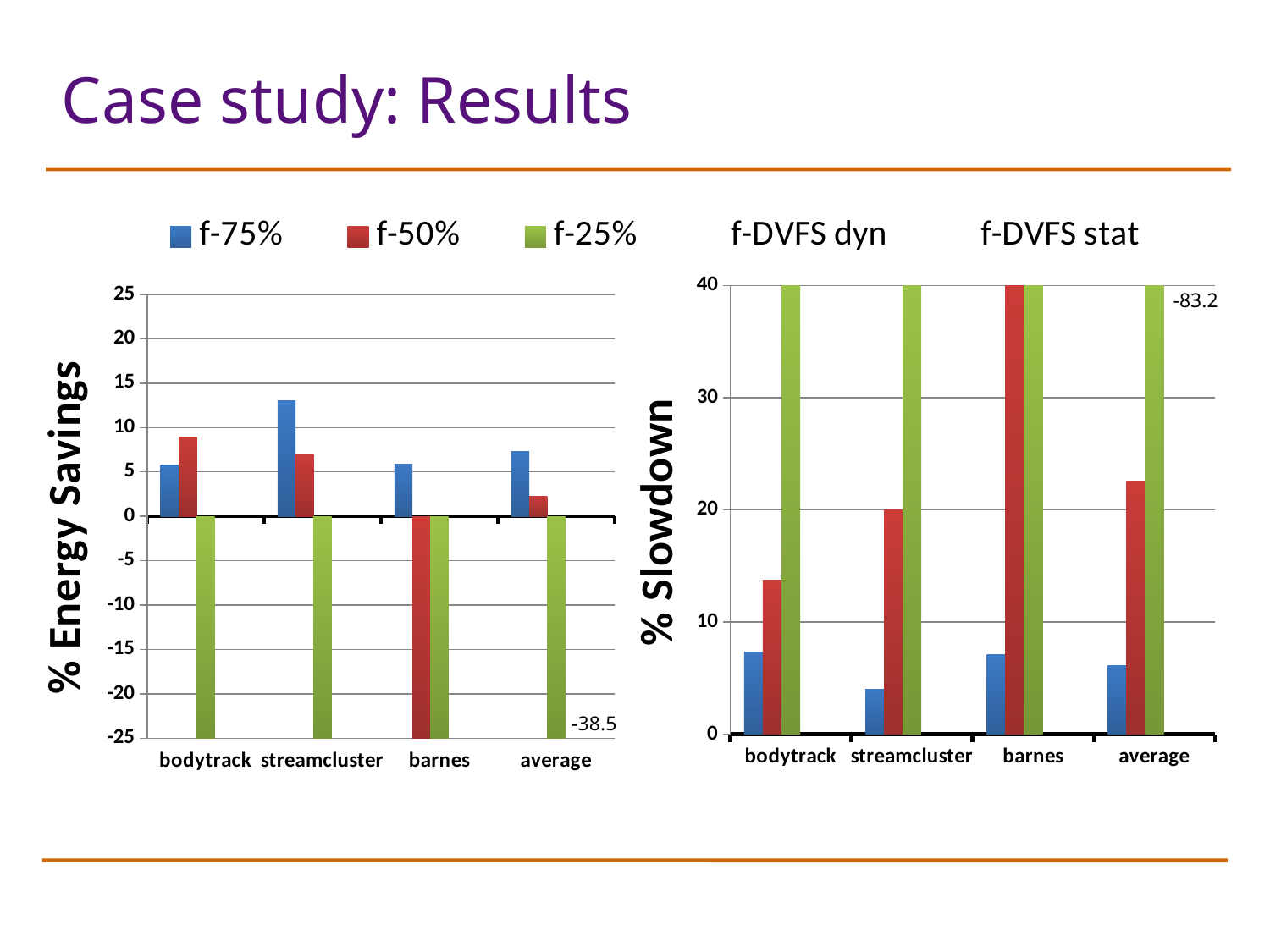
In the % Slowdown chart on the right, is the f-50% value for average greater or less than 20? greater How many categories are shown on the x axis of the % Slowdown chart on the right? 4 In the % Slowdown chart on the right, what value is printed next to the f-25% bar for average? -83.2 What kind of chart is the % Energy Savings chart on the left? bar chart In the % Energy Savings chart on the left, is the f-75% value for streamcluster greater or less than 10? greater In the % Slowdown chart on the right, which category has the lowest f-75% value? streamcluster In the % Energy Savings chart on the left, for bodytrack, which is larger: the f-75% value or the f-50% value? f-50% In the % Slowdown chart on the right, is the f-75% value for bodytrack greater or less than 10? less What is the y-axis title of the chart on the left? % Energy Savings In the % Energy Savings chart on the left, which category has the highest f-75% value? streamcluster In the % Energy Savings chart on the left, what value is printed next to the f-25% bar for average? -38.5